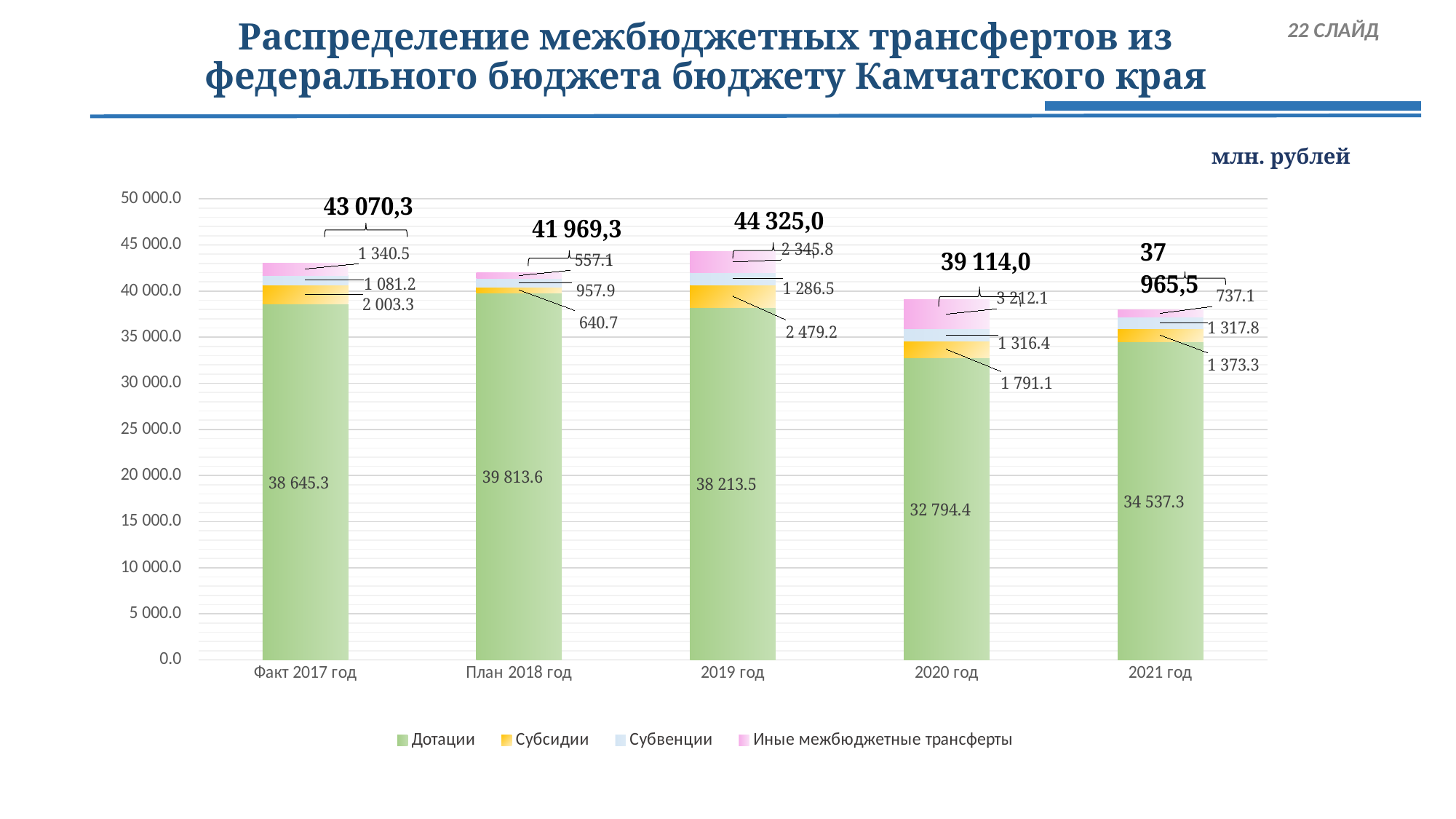
How many series does the legend list? 4 What is the value of Субвенции for 2021 год? 1 317.8 What type of chart is shown on the slide? Stacked bar chart What is the difference between the Дотации values for План 2018 год and 2020 год? 7 019.2 Which is larger: Субсидии for Факт 2017 год or Субсидии for 2021 год? Факт 2017 год What is the total of the stacked bar for План 2018 год? 41 969,3 Which year has the lowest total of transfers? 2021 год What is the value of Субсидии for 2019 год? 2 479.2 What is the value of Дотации for Факт 2017 год? 38 645.3 What is the value of Иные межбюджетные трансферты for 2020 год? 3 212.1 Which year has the highest total of transfers? 2019 год How many categories (years) are shown on the x axis? 5